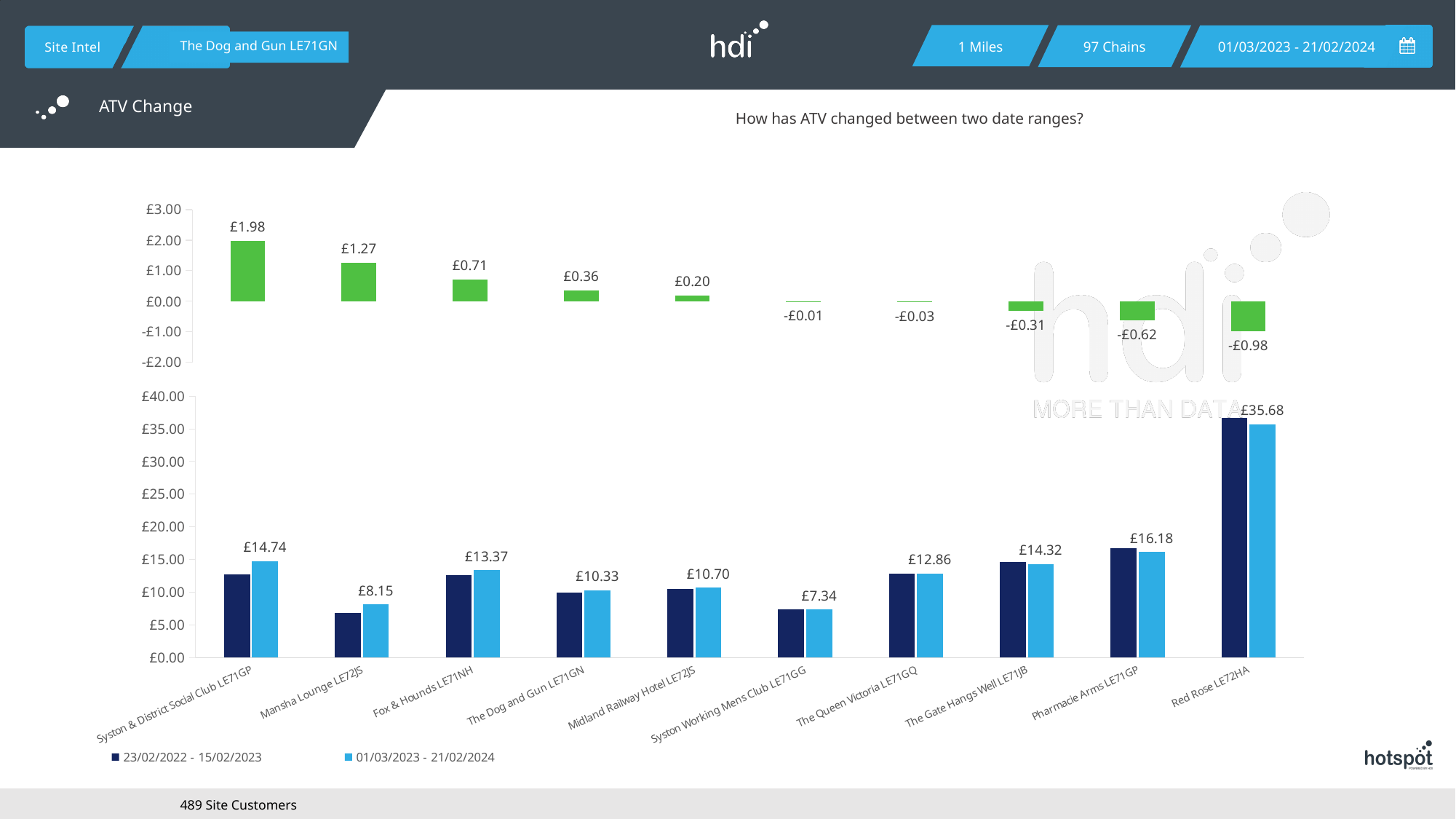
In the bottom chart, what is the value for Mansha Lounge LE72JS in the 01/03/2023 - 21/02/2024 period? £8.15 In the top chart (ATV change), which site has the highest value? Syston & District Social Club LE71GP In the bottom chart, is the 23/02/2022 - 15/02/2023 value for Red Rose LE72HA greater or less than £35.00? greater In the top chart (ATV change), what is the difference between the values for Syston & District Social Club LE71GP and Mansha Lounge LE72JS? £0.71 How many series does the legend of the bottom chart list? 2 In the bottom chart, which has the larger 01/03/2023 - 21/02/2024 value: Fox & Hounds LE71NH or The Queen Victoria LE71GQ? Fox & Hounds LE71NH In the top chart (ATV change), which site has the lowest value? Red Rose LE72HA How many sites are shown in the top chart (ATV change)? 10 In the bottom chart, what is the value for Red Rose LE72HA in the 01/03/2023 - 21/02/2024 period? £35.68 In the top chart (ATV change), what is the value for Syston & District Social Club LE71GP? £1.98 What kind of chart is the bottom chart? Bar chart In the bottom chart, what is the difference between Pharmacie Arms LE71GP and The Gate Hangs Well LE71JB for the 01/03/2023 - 21/02/2024 period? £1.86